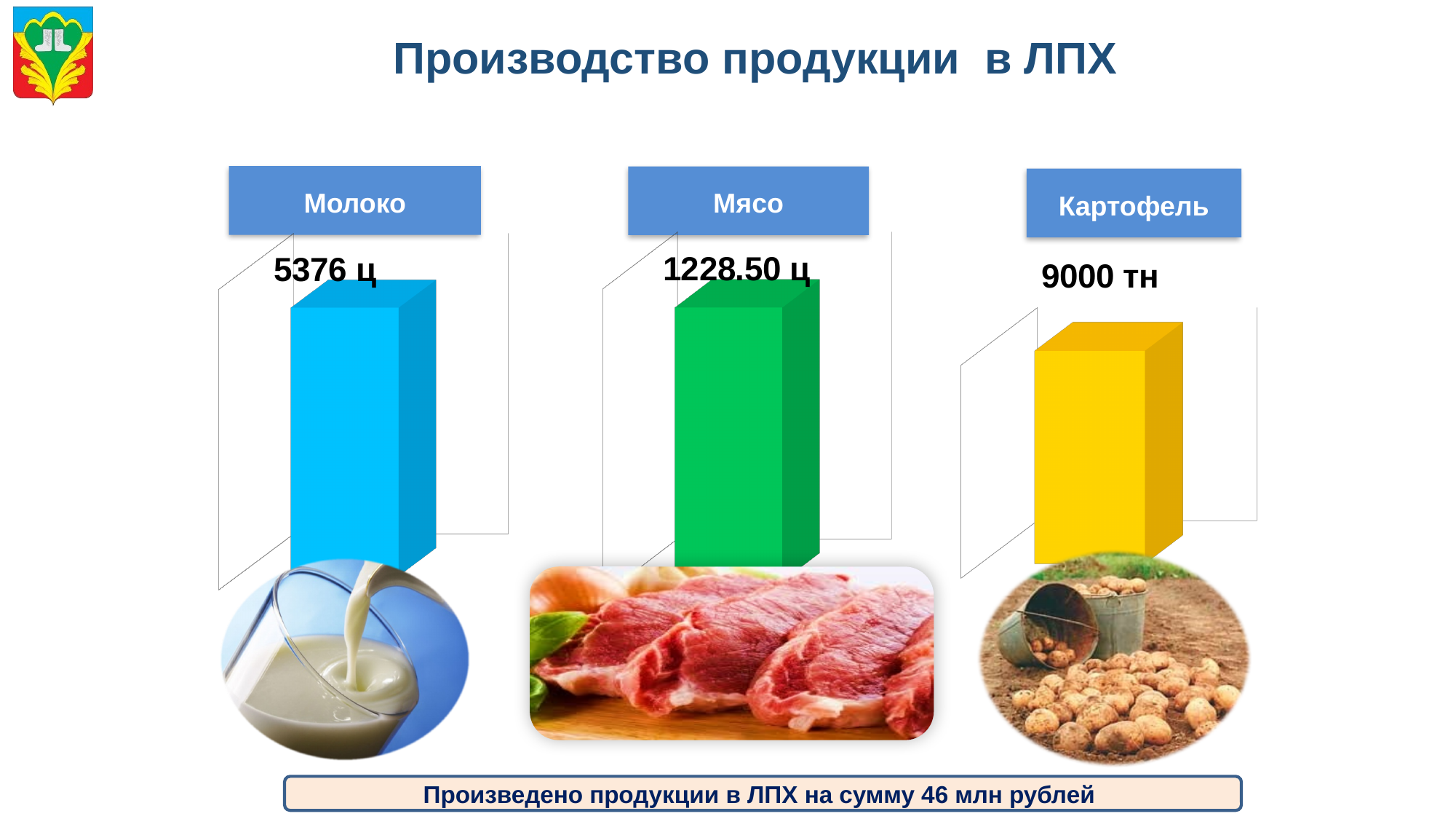
What is the title of the slide containing the bar charts? Производство продукции в ЛПХ What is the value shown for Картофель? 9000 тн What is the difference between the Молоко value and the Мясо value, both given in ц? 4147.50 ц What colour is the bar for Картофель? Yellow What is the value shown for Молоко? 5376 ц What kind of chart is used to show each product's value on the slide? Bar chart What unit is used for the Картофель value? тн What is the value shown for Мясо? 1228.50 ц Which of the two values given in ц is larger, Молоко or Мясо? Молоко How many product categories are shown with bars on the slide? 3